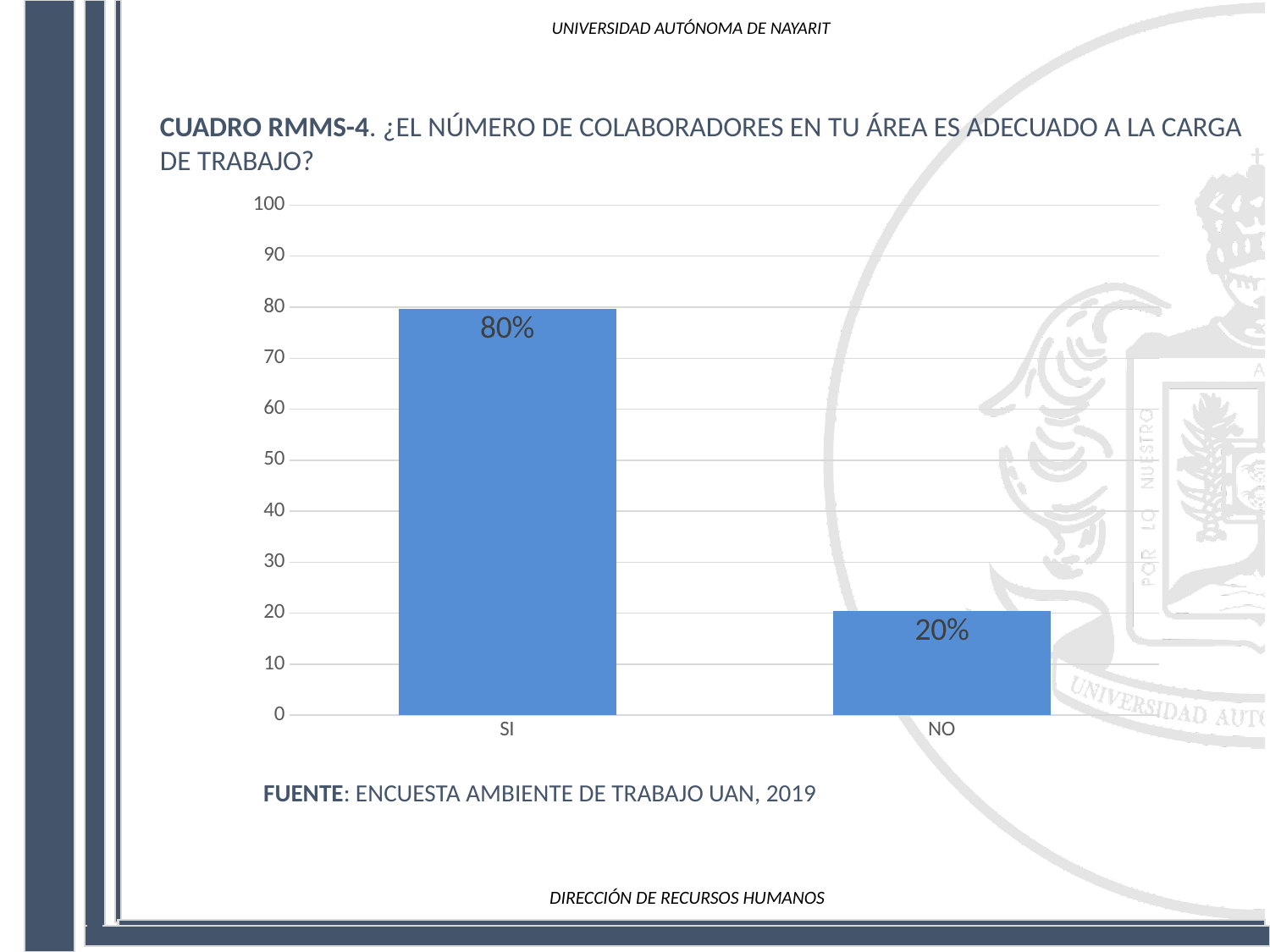
Which category has the lowest value? NO What is the maximum value shown on the vertical axis? 100 What is the value for SI? 80% What source is cited below the chart? ENCUESTA AMBIENTE DE TRABAJO UAN, 2019 Which is larger, the value for SI or the value for NO? SI What is the difference between the values for SI and NO? 60% What is the value for NO? 20% Is the value for SI greater or less than 50? greater Is the value for NO greater or less than 30? less Which category has the highest value? SI What kind of chart is shown on the slide? bar chart How many categories are shown on the x axis? 2